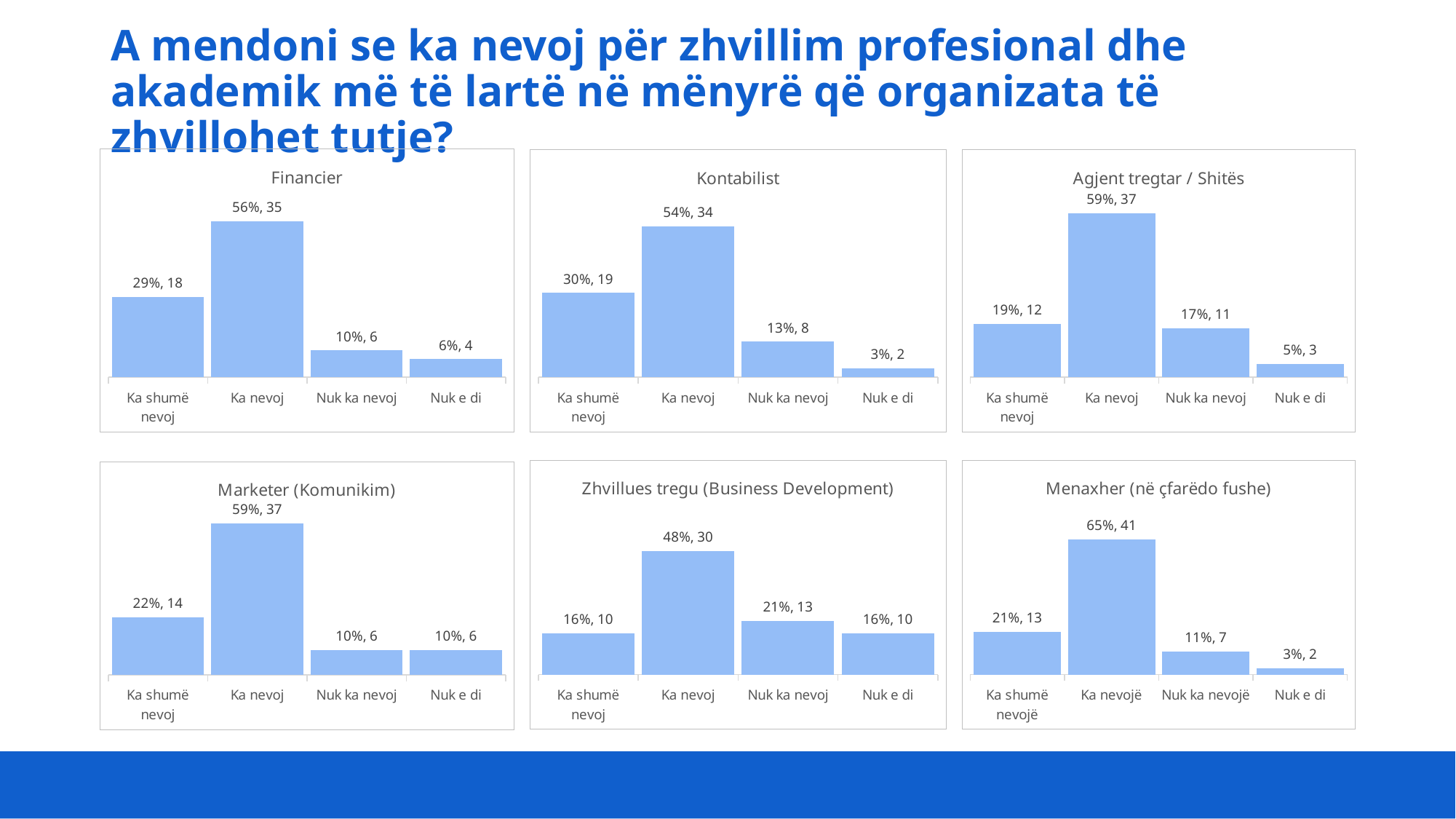
In the 'Zhvillues tregu (Business Development)' chart, what is the difference in count between 'Ka nevoj' and 'Nuk ka nevoj'? 17 In the 'Agjent tregtar / Shitës' chart, which category has the highest value? Ka nevoj How many charts are shown on the slide? 6 What type of chart is the 'Menaxher (në çfarëdo fushe)' chart? Bar chart In the 'Kontabilist' chart, what is the data label for 'Nuk e di'? 3%, 2 In the 'Agjent tregtar / Shitës' chart, what is the data label for 'Nuk ka nevoj'? 17%, 11 In the 'Menaxher (në çfarëdo fushe)' chart, which category has the lowest value? Nuk e di In the 'Marketer (Komunikim)' chart, what is the data label for 'Ka shumë nevoj'? 22%, 14 In the 'Menaxher (në çfarëdo fushe)' chart, what percentage is shown for 'Ka nevojë'? 65% In the 'Financier' chart, what is the data label for 'Ka nevoj'? 56%, 35 In the 'Kontabilist' chart, which is larger: 'Ka shumë nevoj' or 'Nuk ka nevoj'? Ka shumë nevoj How many categories are shown in the 'Financier' chart? 4